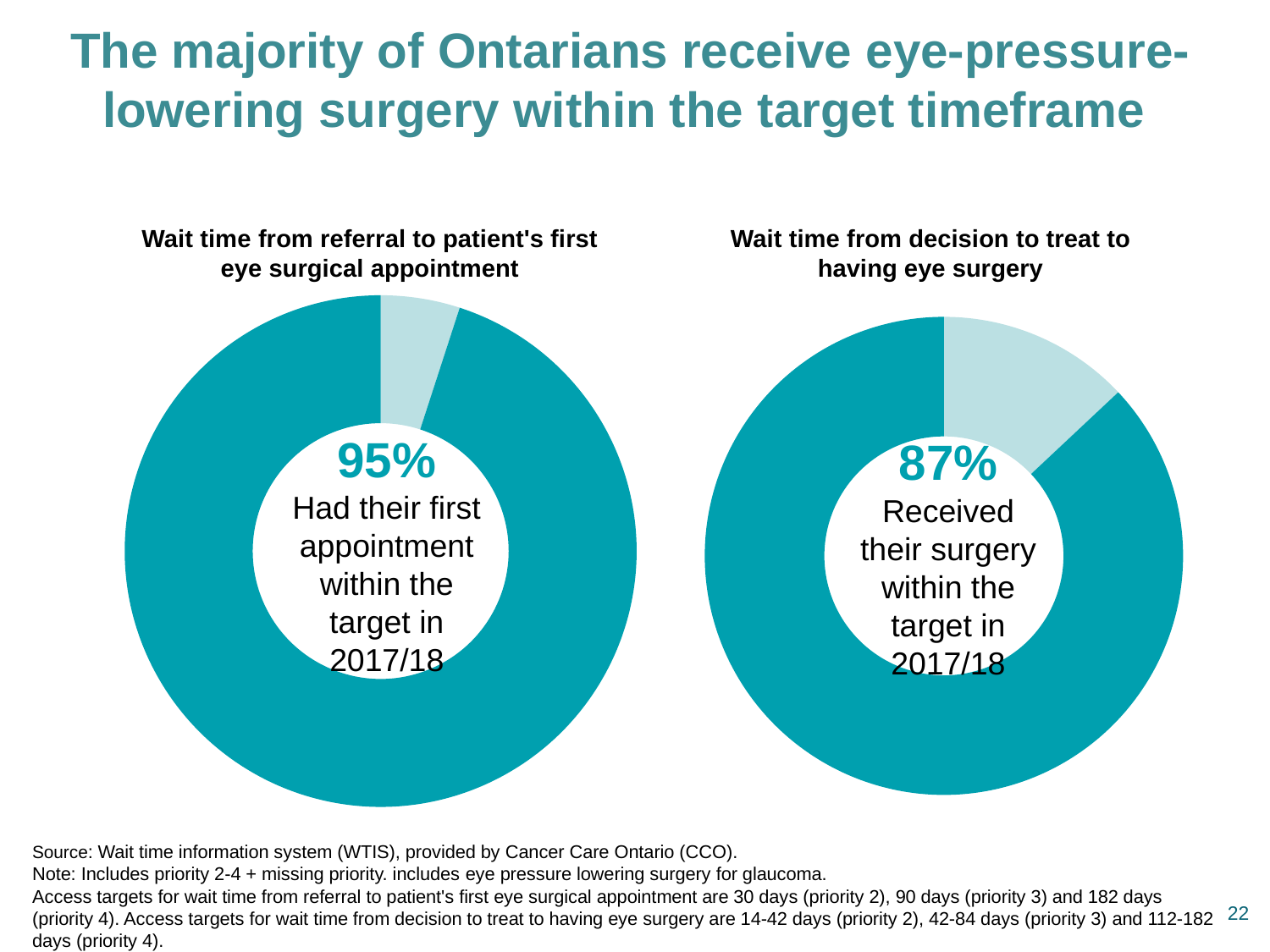
In the chart titled "Wait time from referral to patient's first eye surgical appointment", which slice is larger: the dark teal slice or the light slice? the dark teal slice How many charts are shown on the slide? 2 In the chart titled "Wait time from decision to treat to having eye surgery", what percentage of patients received their surgery within the target in 2017/18? 87% What is the title of the chart on the right side of the slide? Wait time from decision to treat to having eye surgery What fiscal year do the percentages in both charts refer to? 2017/18 What is the difference in percentage points between the share within target in the referral-to-first-appointment chart (95%) and the decision-to-treat-to-surgery chart (87%)? 8 percentage points In the chart titled "Wait time from referral to patient's first eye surgical appointment", what percentage of patients had their first appointment within the target in 2017/18? 95% In the chart titled "Wait time from decision to treat to having eye surgery", how many slices does the donut have? 2 Which chart shows the higher percentage of patients within the target: the referral-to-first-appointment chart or the decision-to-treat-to-surgery chart? Wait time from referral to patient's first eye surgical appointment What kind of chart is used on this slide to show the wait time results? donut (pie) chart